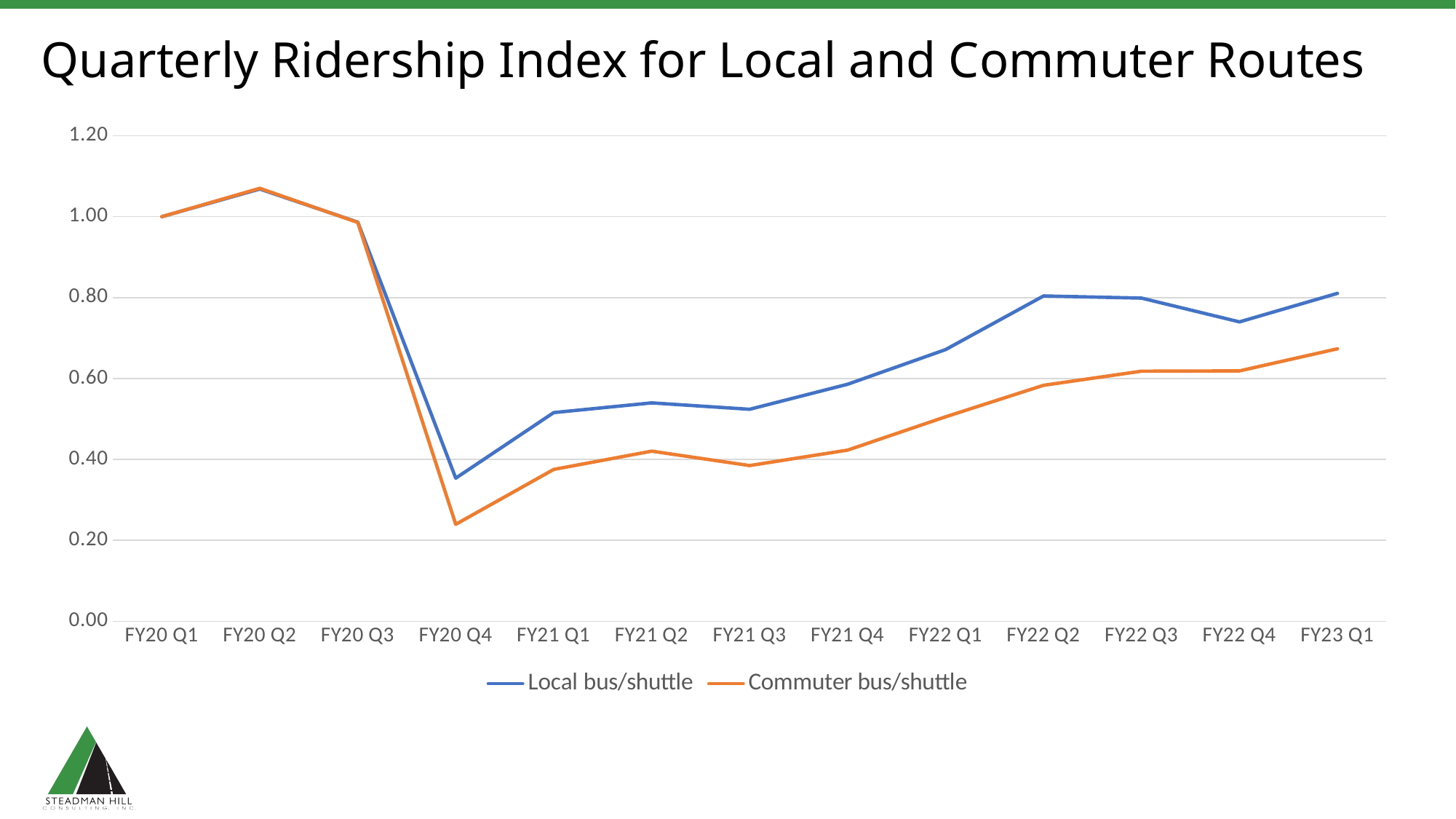
In FY22 Q3, which series has the higher value, Local bus/shuttle or Commuter bus/shuttle? Local bus/shuttle How many quarters are plotted along the x axis? 13 Is the value for Commuter bus/shuttle in FY20 Q4 greater or less than 0.40? less What is the value for Local bus/shuttle in FY20 Q1? 1.00 Does the Local bus/shuttle index rise or fall from FY21 Q3 to FY22 Q2? rise Is the value for Local bus/shuttle in FY21 Q1 greater or less than 0.40? greater What kind of chart is shown on the slide? line chart In which quarter is the Commuter bus/shuttle index highest? FY20 Q2 In which quarter is the Commuter bus/shuttle index lowest? FY20 Q4 How many series does the legend list? 2 In which quarter is the Local bus/shuttle index lowest? FY20 Q4 Is the value for Commuter bus/shuttle in FY23 Q1 greater or less than 0.60? greater